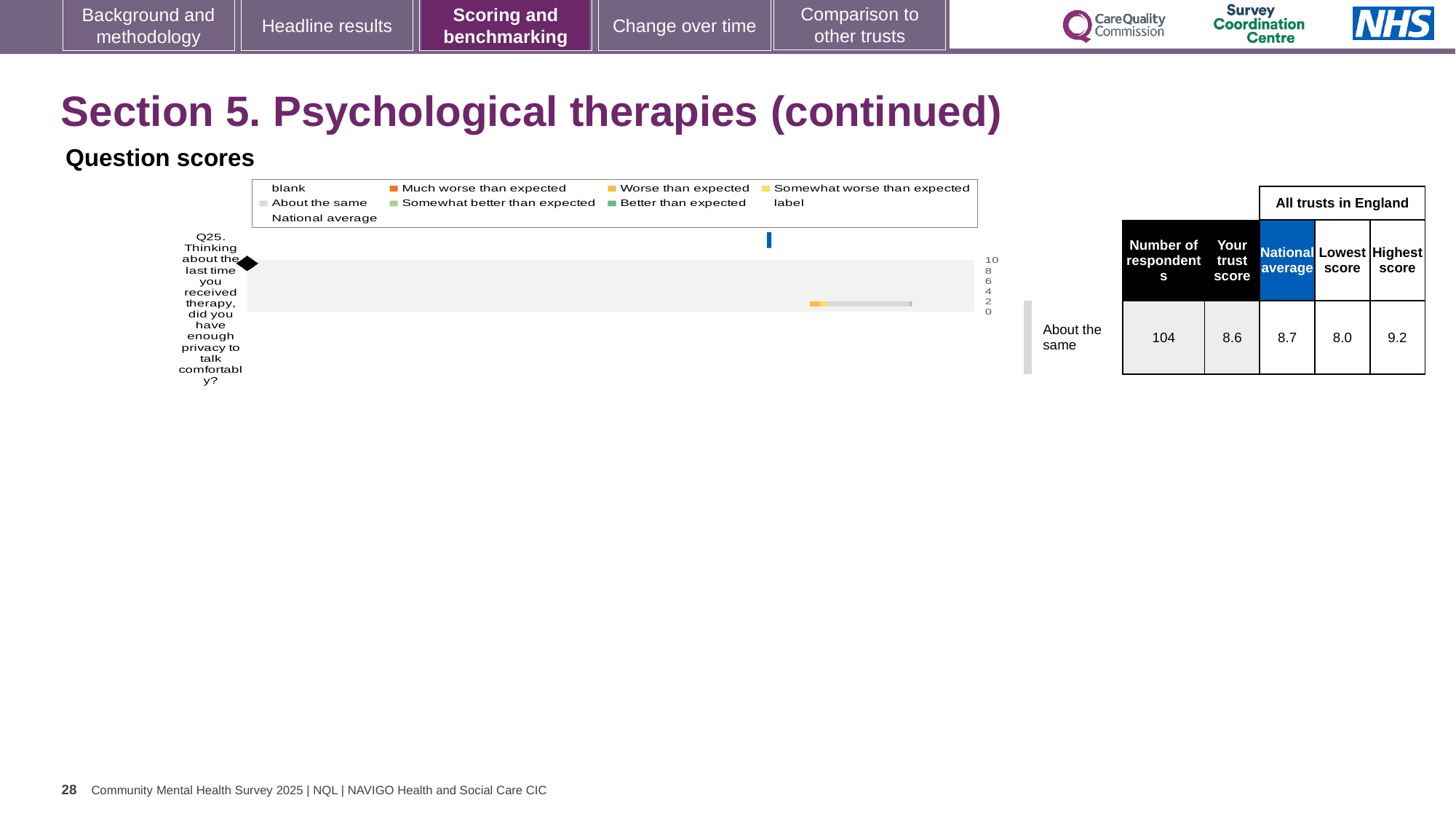
Which question is plotted in the question scores chart? Q25. Thinking about the last time you received therapy, did you have enough privacy to talk comfortably? How many survey questions are plotted in the question scores chart? 1 What is the difference between the highest and lowest trust scores for Q25? 1.2 What type of chart is used for the Q25 question scores? bar chart For Q25, which is larger: the trust's score or the national average? national average What is the lowest score among all trusts in England for Q25? 8.0 What is the highest score among all trusts in England for Q25? 9.2 What benchmark category is shown for Q25 next to the chart? About the same What is the national average score for Q25? 8.7 How many respondents answered Q25? 104 Is the trust's score for Q25 greater or less than 8? greater What is the trust's score for Q25 according to the table beside the chart? 8.6